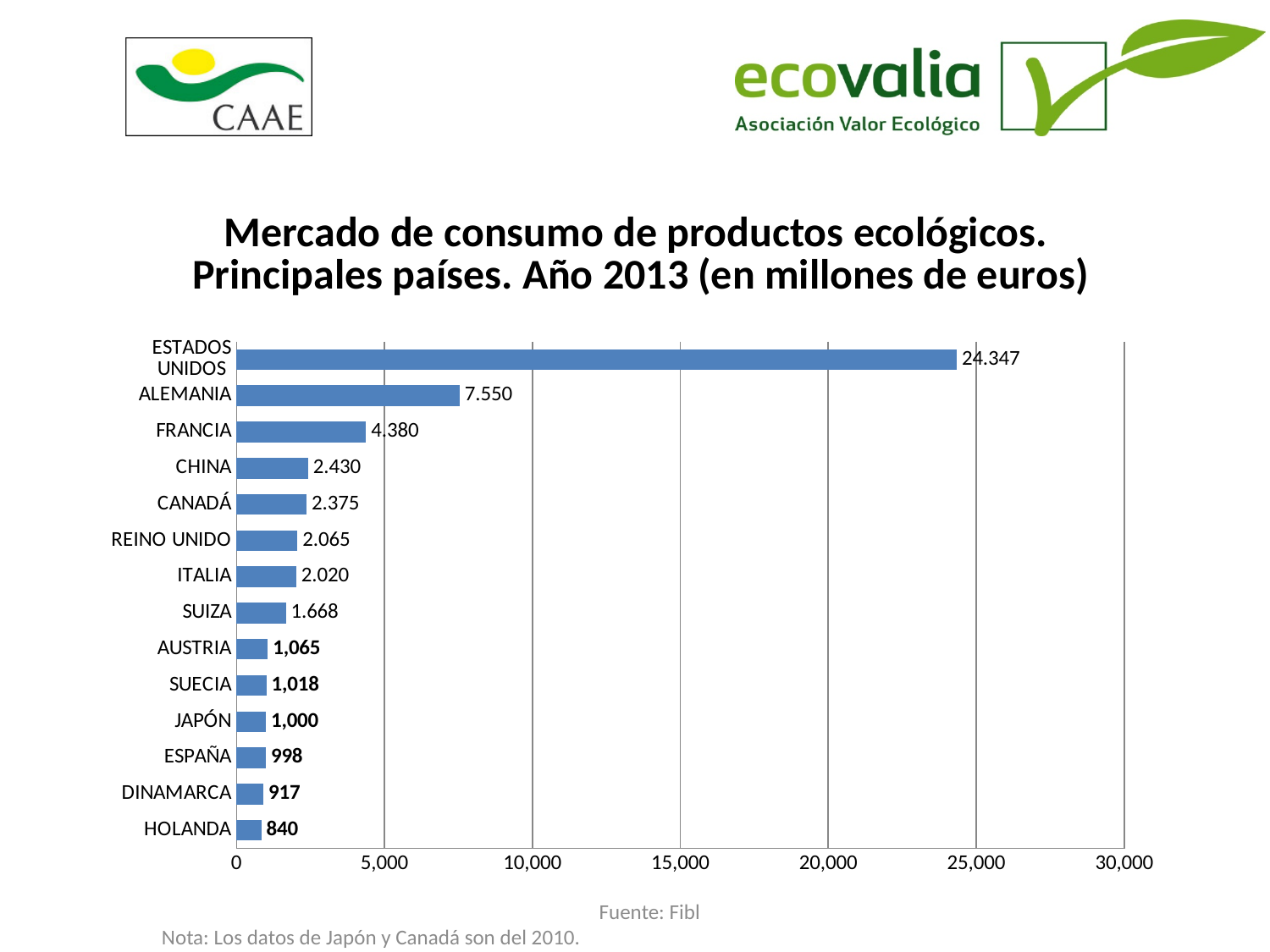
Is the value for ESTADOS UNIDOS greater or less than 20,000? greater What is the difference between the values for DINAMARCA and HOLANDA? 77 What is the value for ALEMANIA? 7.550 Which is larger, the value for FRANCIA or the value for CHINA? FRANCIA What kind of chart is shown on the slide? bar chart What source is cited below the chart? Fibl What is the value for CANADÁ? 2.375 Which country has the highest value? ESTADOS UNIDOS Which country has the lowest value? HOLANDA How many countries are shown in the chart? 14 What is the difference between the values for AUSTRIA and ESPAÑA? 67 What is the value for ESPAÑA? 998